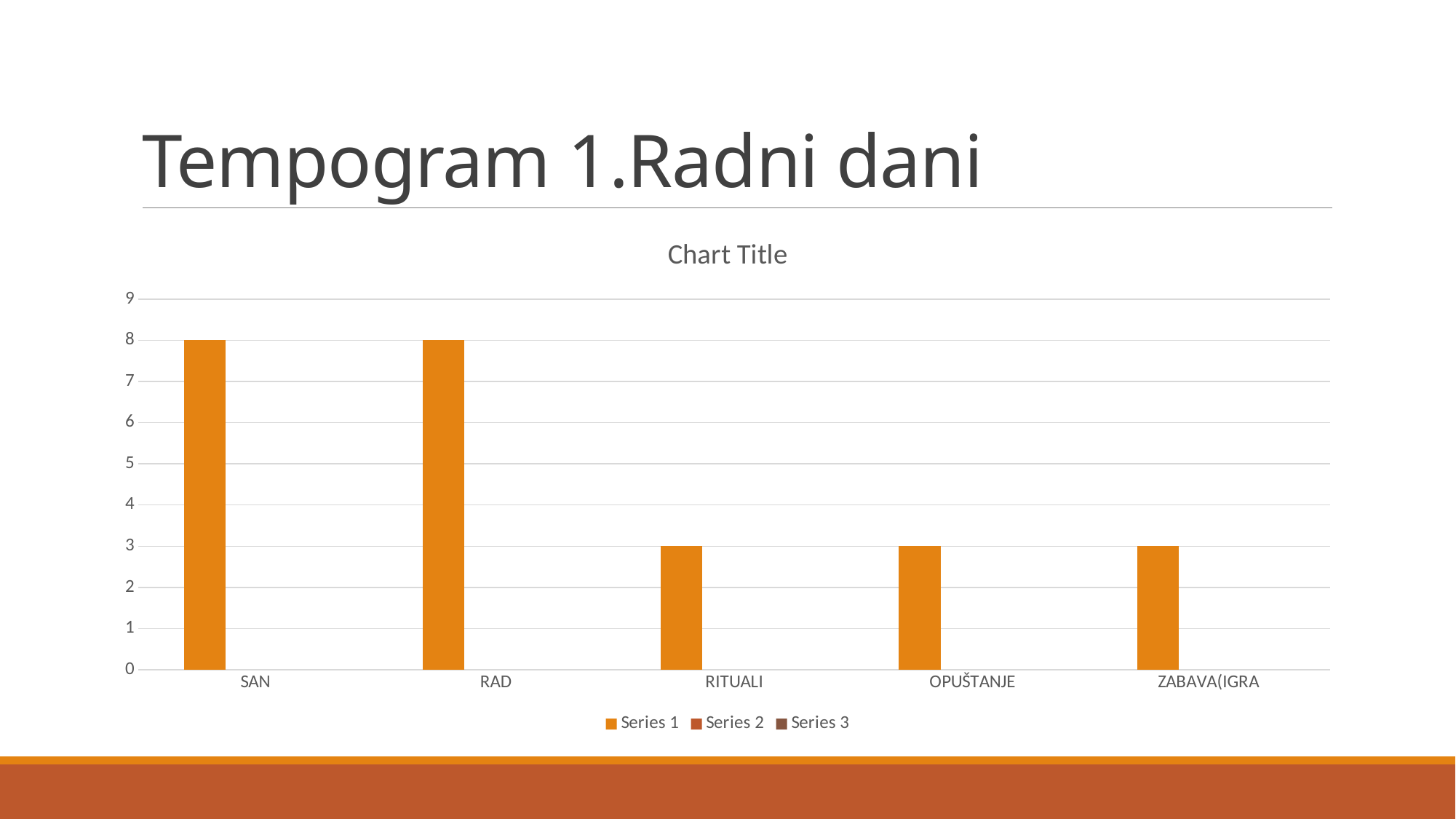
What is the value for SAN? 8 How many series does the legend list? 3 What is the difference between the values for SAN and RITUALI? 5 What is the title shown above the chart? Chart Title What kind of chart is shown on the slide? bar chart What is the value for RAD? 8 Is the value for SAN greater or less than 5? greater What is the value for OPUŠTANJE? 3 How many categories are shown on the x axis? 5 What is the value for ZABAVA(IGRA? 3 What is the value for RITUALI? 3 Which is larger, the value for RAD or the value for OPUŠTANJE? RAD